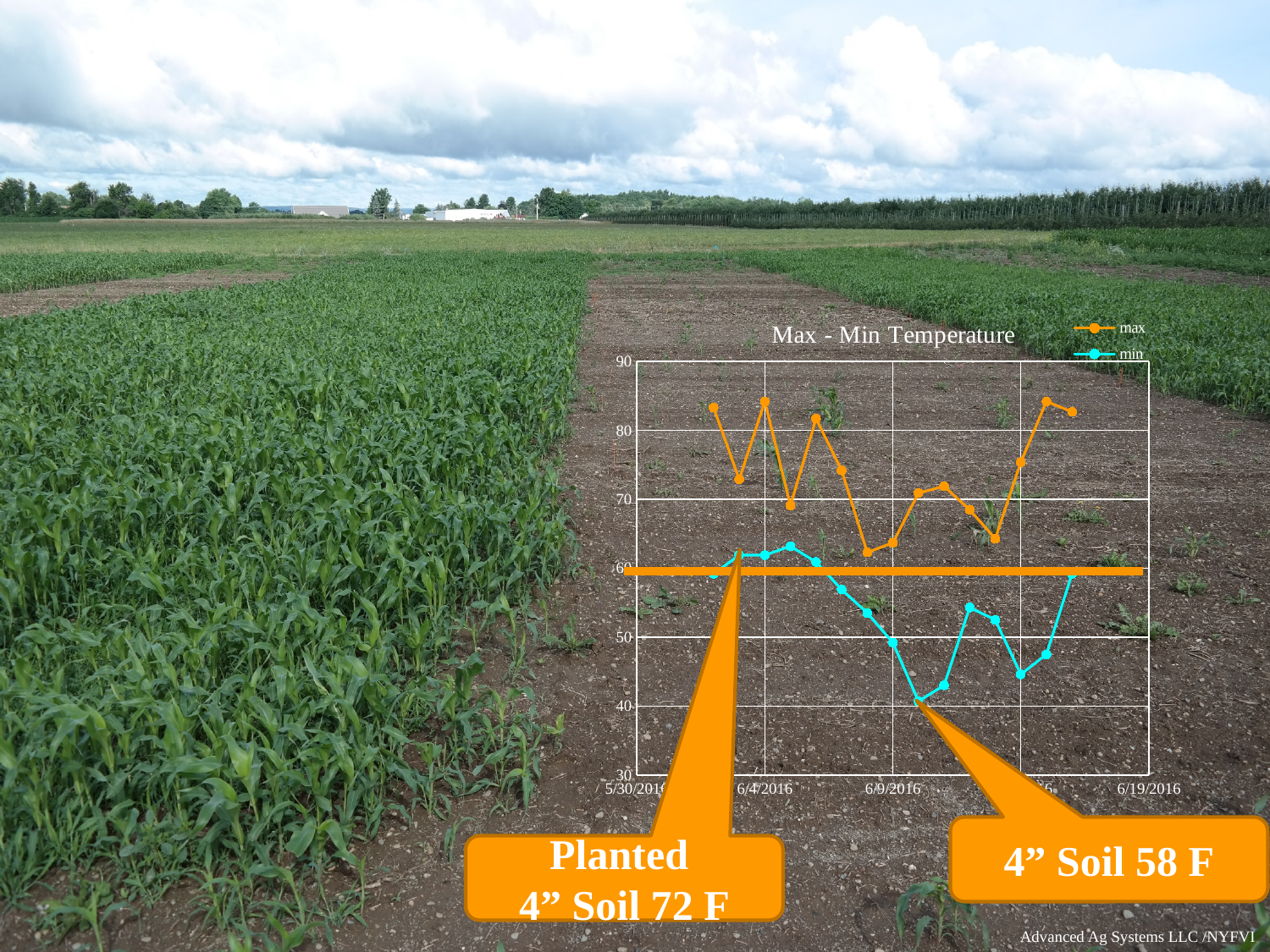
How many series does the chart legend list? 2 Is the value of the max series on 6/9/2016 greater or less than 70? less Is the value of the min series on 6/4/2016 greater or less than 70? less What is the title of the chart? Max - Min Temperature Which series reaches the lowest value on the chart, max or min? min What kind of chart is shown on the slide? line chart What is the highest value shown on the vertical axis of the chart? 90 Does the min series rise or fall between 6/4/2016 and 6/9/2016? fall On 6/4/2016, which series has the larger value, max or min? max Is the lowest point of the min series greater or less than 50? less Which two series are listed in the chart legend? max and min